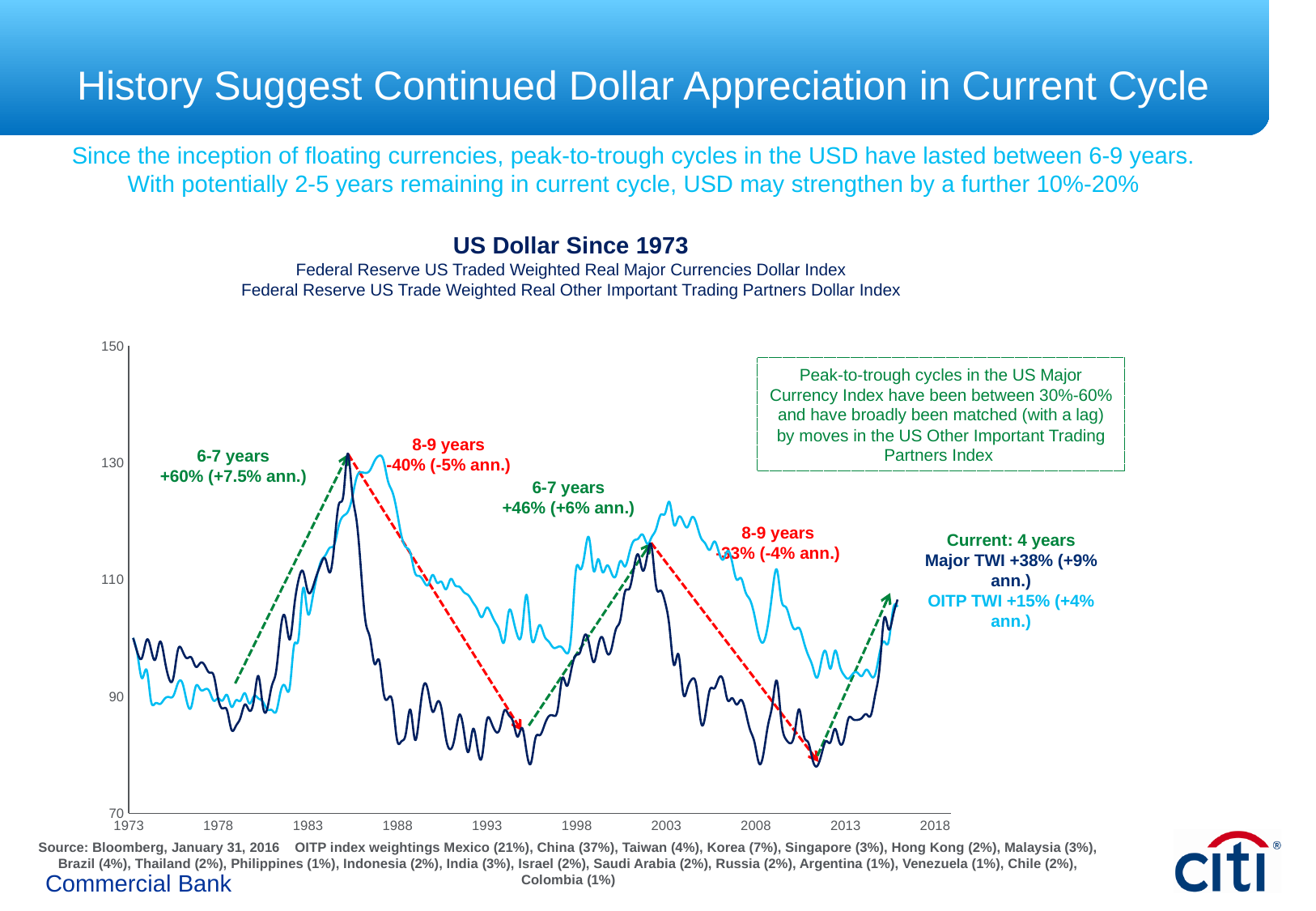
Is the value of the Major Currencies index at its trough around 1995 greater or less than 90? less How many index series are plotted on the chart? 2 What kind of chart is shown on the slide? line chart What is the title of the chart? US Dollar Since 1973 Does the Major Currencies index rise or fall between its 1985 peak and 1995? fall What is the highest value shown on the vertical axis? 150 According to the annotation, how long did the first depreciation cycle after 1985 last? 8-9 years What percentage decline is annotated for the depreciation cycle from about 2002 to 2011? -33% (-4% ann.) According to the annotation, by what percentage did the dollar index rise in the first appreciation cycle (ending around 1985)? +60% (+7.5% ann.) Is the value of the Major Currencies index at its peak around 2002 greater or less than 110? greater What gain is annotated for the OITP TWI in the current cycle? +15% (+4% ann.) What gain is annotated for the Major TWI in the current cycle? +38% (+9% ann.)